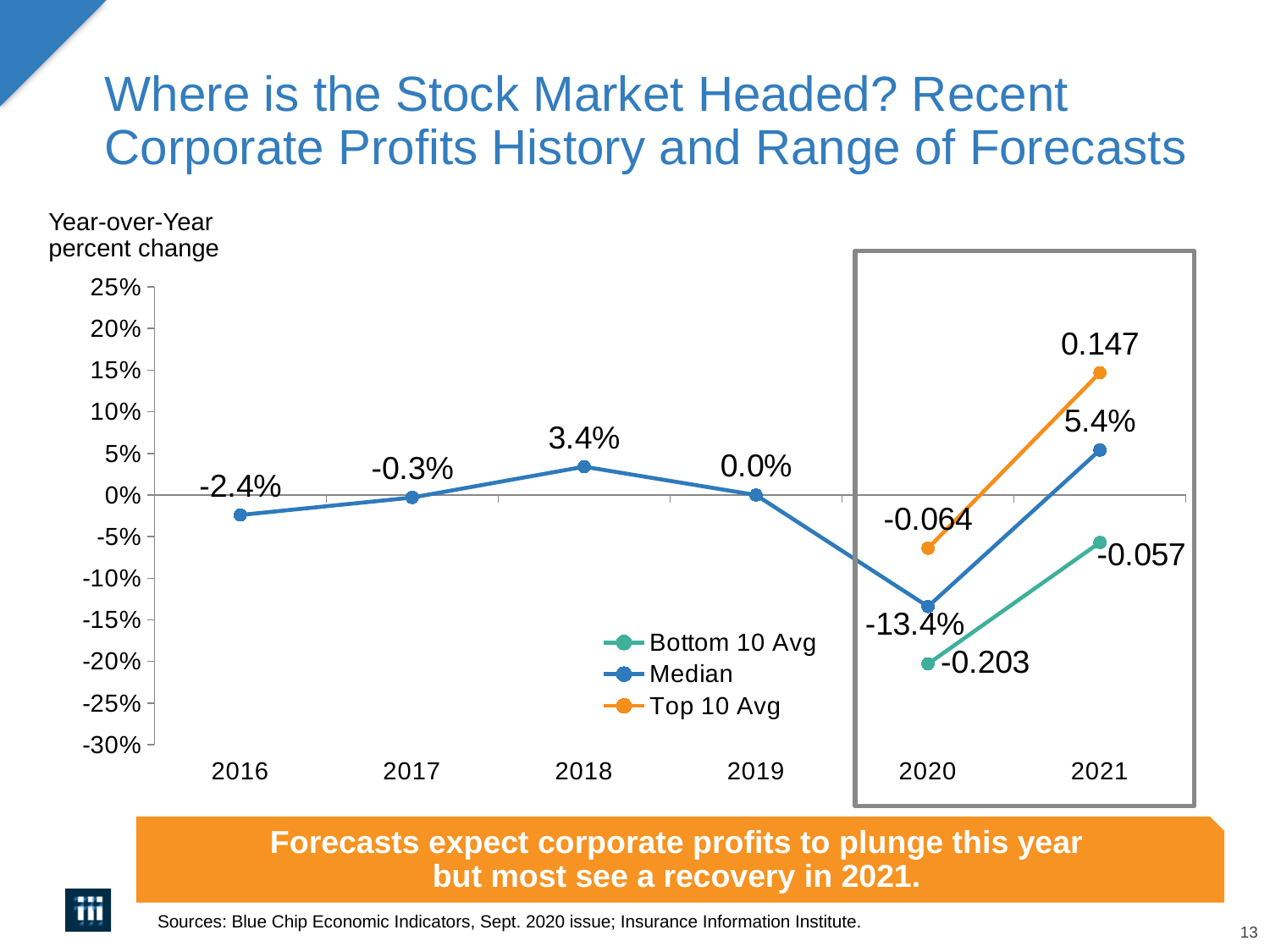
What type of chart is shown on the slide? line chart Which is larger for 2021, the Top 10 Avg or the Bottom 10 Avg? Top 10 Avg Does the Median series rise or fall from 2020 to 2021? rise What is the Bottom 10 Avg value for 2020? -0.203 In which year is the Median series at its highest? 2021 What is the Top 10 Avg value for 2021? 0.147 What is the Median value for 2016? -2.4% How many series does the legend list? 3 What is the Median value for 2018? 3.4% How many years are shown on the x axis? 6 In which year is the Median series at its lowest? 2020 What is the Median value for 2020? -13.4%